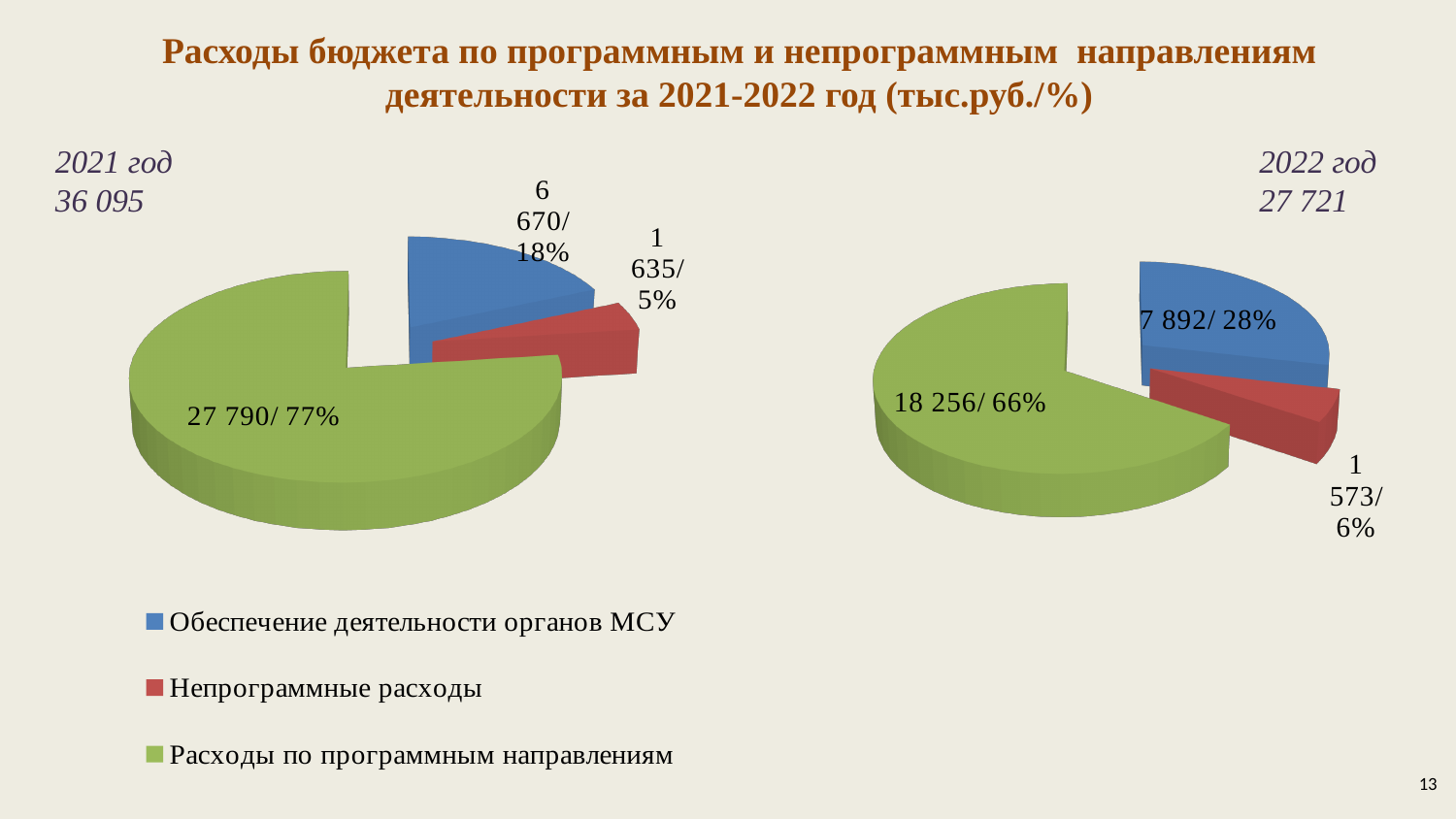
How many categories does the legend list? 3 In the 2022 год pie chart, what is the value for Обеспечение деятельности органов МСУ? 7 892/ 28% In the 2021 год pie chart, what is the value for Расходы по программным направлениям? 27 790/ 77% In the 2022 год pie chart, what is the value for Непрограммные расходы? 1 573/ 6% What is the difference between Расходы по программным направлениям in 2021 год and in 2022 год (in тыс.руб.)? 9 534 What share of the 2021 год pie does Непрограммные расходы take? 5% What type of charts are shown on the slide? Pie charts Which is larger: Обеспечение деятельности органов МСУ in 2021 год or in 2022 год? 2022 год In the 2022 год pie chart, which category has the largest slice? Расходы по программным направлениям In the 2021 год pie chart, what is the value for Обеспечение деятельности органов МСУ? 6 670/ 18% In the 2021 год pie chart, which category has the smallest slice? Непрограммные расходы What share of the 2022 год pie does Расходы по программным направлениям take? 66%